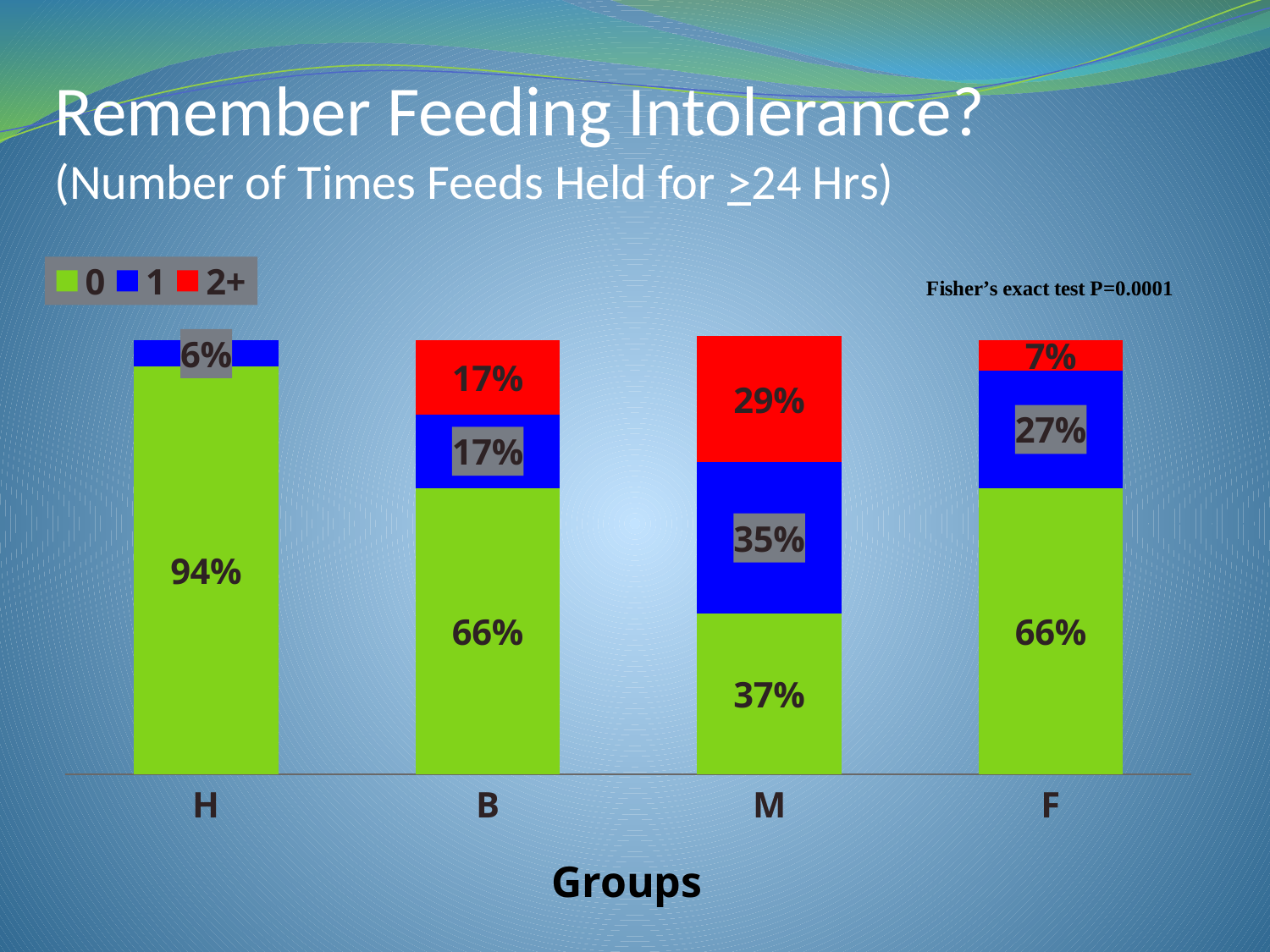
How many groups are shown on the x axis? 4 What percentage of group H had feeds held 0 times? 94% Which is larger: the '1' series value for group M or for group B? M What is the value of the '2+' series for group F? 7% How many series does the legend list? 3 What is the value of the '2+' series for group B? 17% Which group has the highest value for the '2+' series? M Which group has the highest value for the '0' series? H Which group has the lowest value for the '0' series? M What kind of chart is shown on the slide? Stacked bar chart What is the difference between the '1' series values for group F and group H? 21% What is the value of the '1' series for group M? 35%